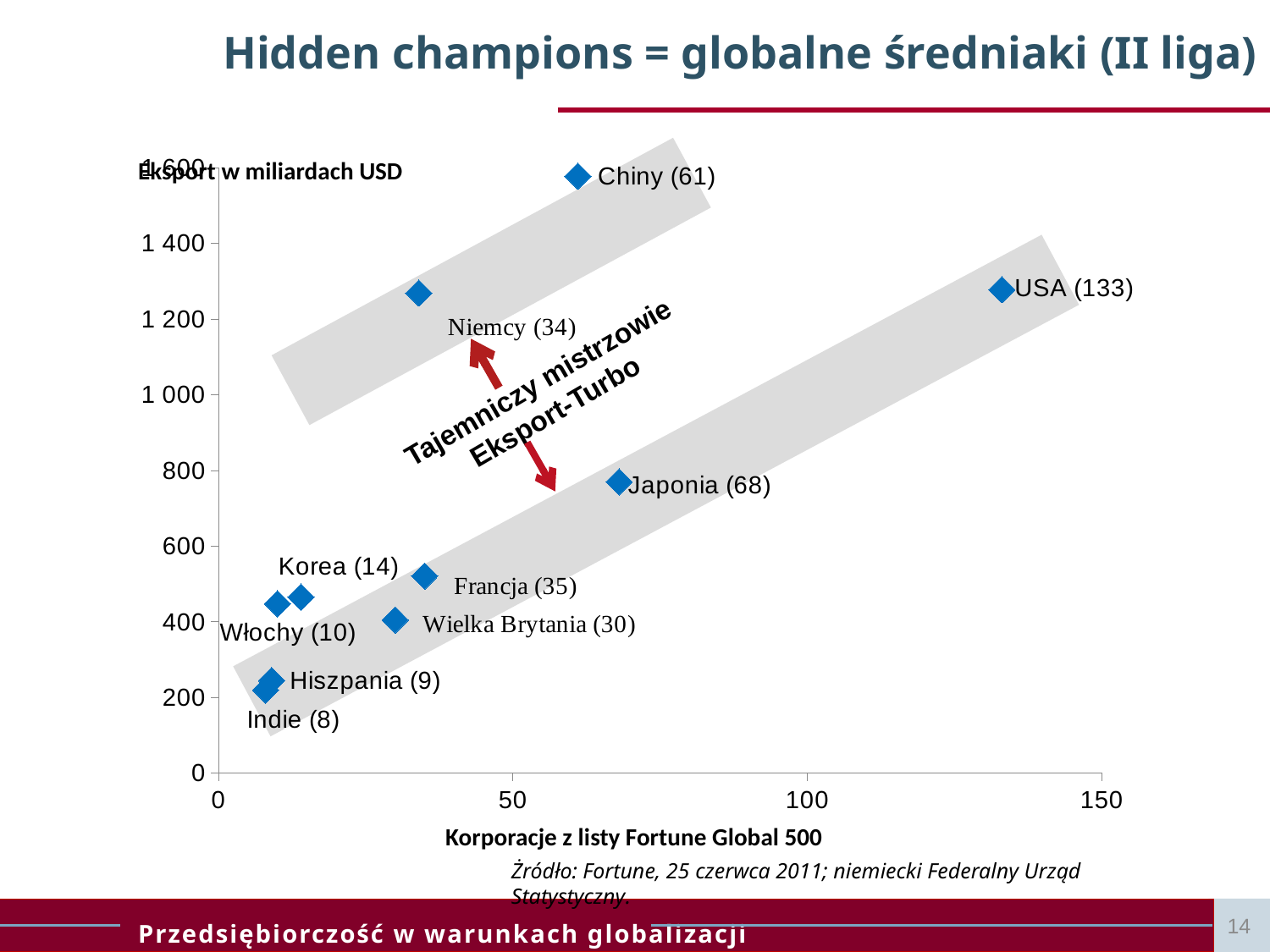
What is the difference between the number of Fortune Global 500 corporations of USA and Chiny? 72 Which country has the highest export value on the chart? Chiny How many countries are plotted as points on the chart? 10 Is the export value for Japonia greater or less than 1 000? less Which has a higher export value, Chiny or USA? Chiny Which country has the fewest Fortune Global 500 corporations? Indie According to the label, how many Fortune Global 500 corporations does Chiny have? 61 According to the label, how many Fortune Global 500 corporations does USA have? 133 According to the label, how many Fortune Global 500 corporations does Niemcy have? 34 Which country has the most Fortune Global 500 corporations? USA What is the title of the x axis? Korporacje z listy Fortune Global 500 What kind of chart is shown on the slide? scatter chart